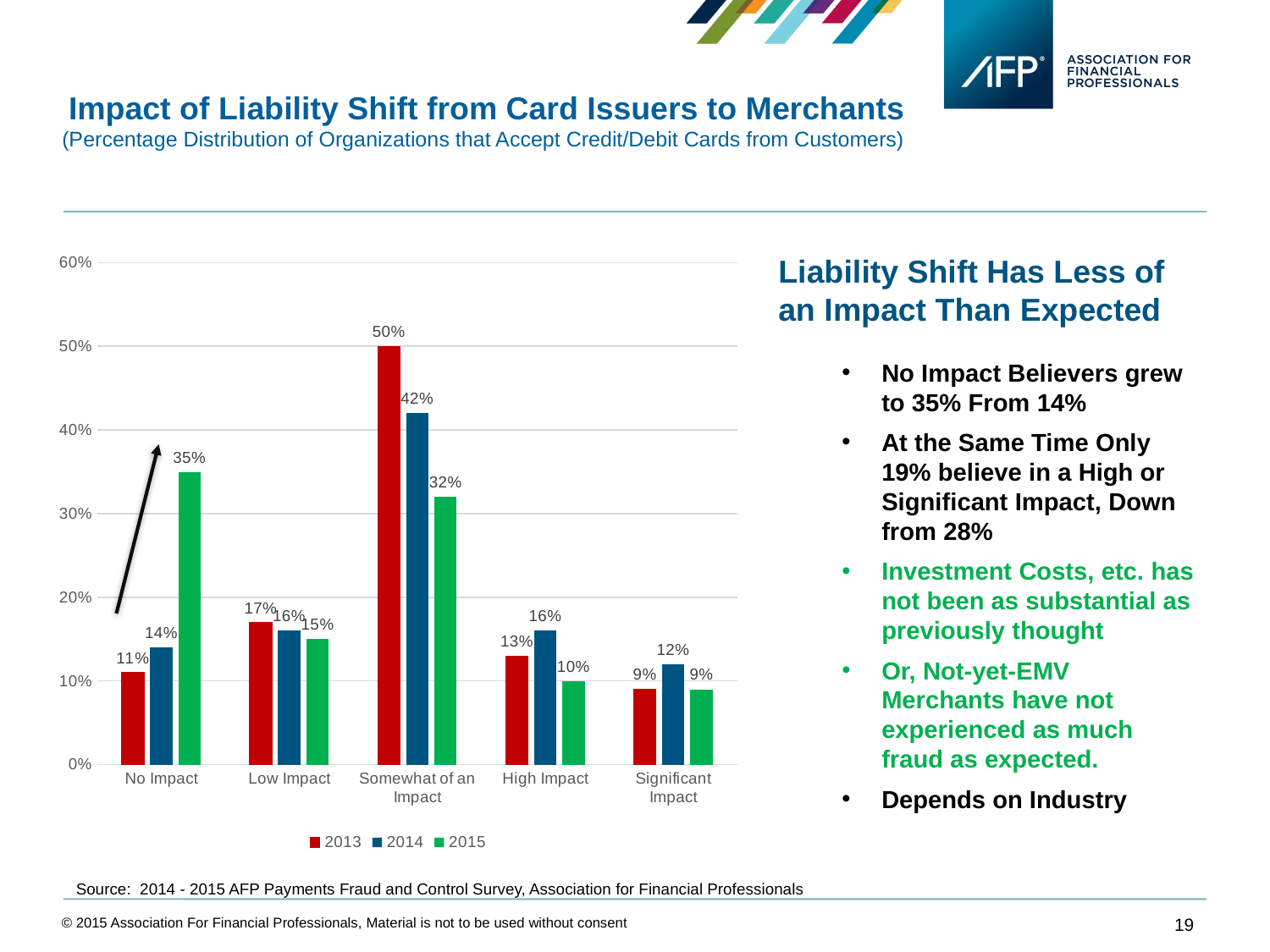
What is the 2014 value for Significant Impact? 12% Which category has the highest 2014 value? Somewhat of an Impact Which category has the lowest 2015 value? Significant Impact How many categories are shown on the x axis? 5 What colour represents the 2015 series in the legend? Green What is the 2013 value for Somewhat of an Impact? 50% Do the values for Somewhat of an Impact rise or fall from 2013 to 2015? Fall Which is larger for High Impact: the 2014 value or the 2015 value? 2014 How many series does the legend list? 3 What is the 2015 value for No Impact? 35% What is the difference between the 2015 and 2013 values for No Impact? 24% What kind of chart is shown on the slide? Bar chart